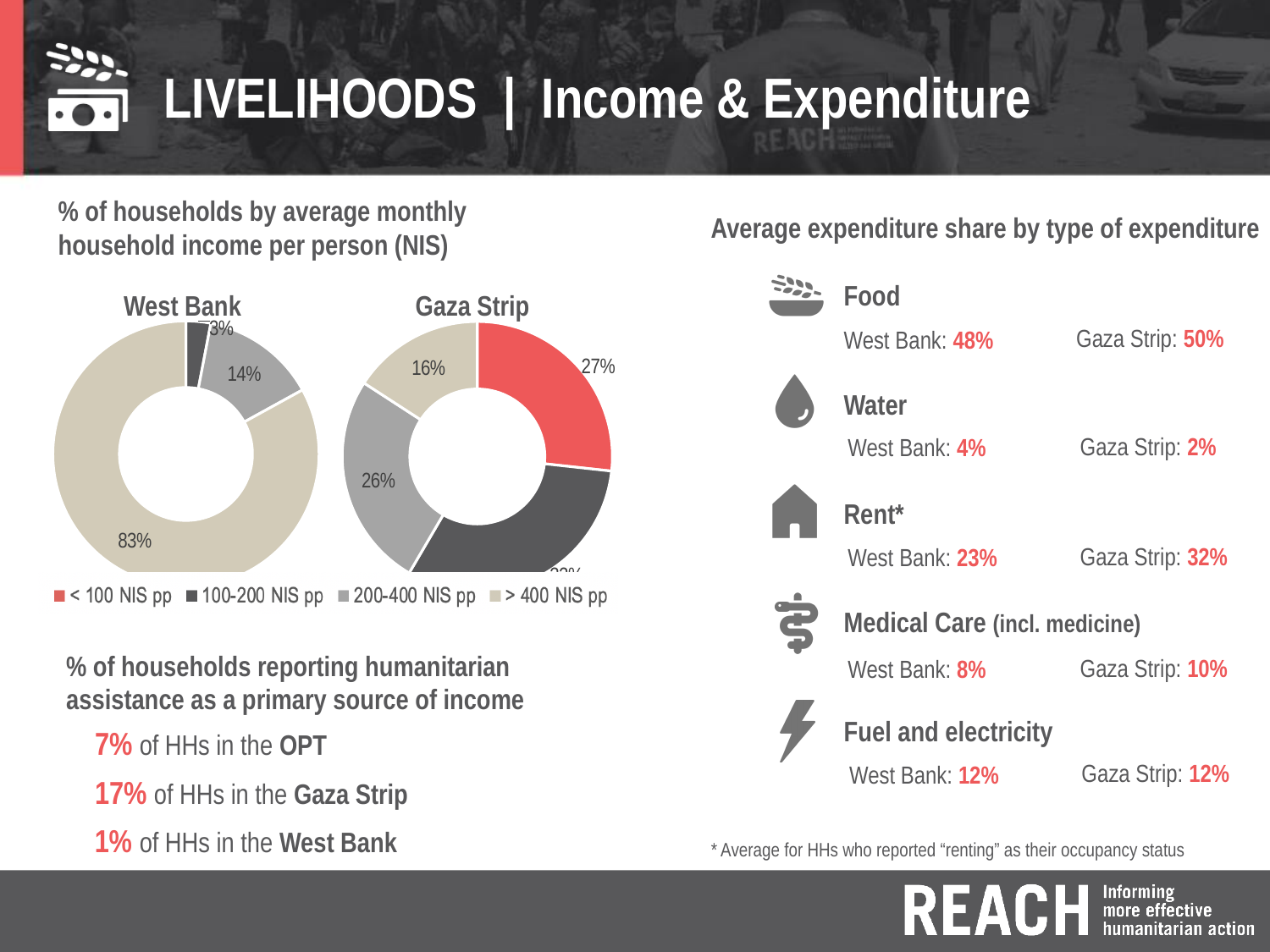
In the legend below the donut charts, which colour represents the < 100 NIS pp category? Red In the West Bank donut chart, which income category has the largest share of households? > 400 NIS pp In the Gaza Strip donut chart, what percentage of households fall in the > 400 NIS pp category? 16% Which is larger in the Gaza Strip donut chart: the share of households with < 100 NIS pp or the share with 200-400 NIS pp? < 100 NIS pp What type of chart is used to show the % of households by average monthly household income per person? Donut (pie) chart How many income categories does the legend below the donut charts list? 4 In the Gaza Strip donut chart, which of the labelled income categories has the smallest share of households? > 400 NIS pp In the West Bank donut chart, what percentage of households fall in the 200-400 NIS pp category? 14% In the West Bank donut chart, what percentage of households have an average monthly income per person of > 400 NIS pp? 83% What is the difference between the share of households with > 400 NIS pp income in the West Bank and in the Gaza Strip? 67% In the Gaza Strip donut chart, what percentage of households have an average monthly income per person of < 100 NIS pp? 27% In the Gaza Strip donut chart, what percentage of households fall in the 200-400 NIS pp category? 26%